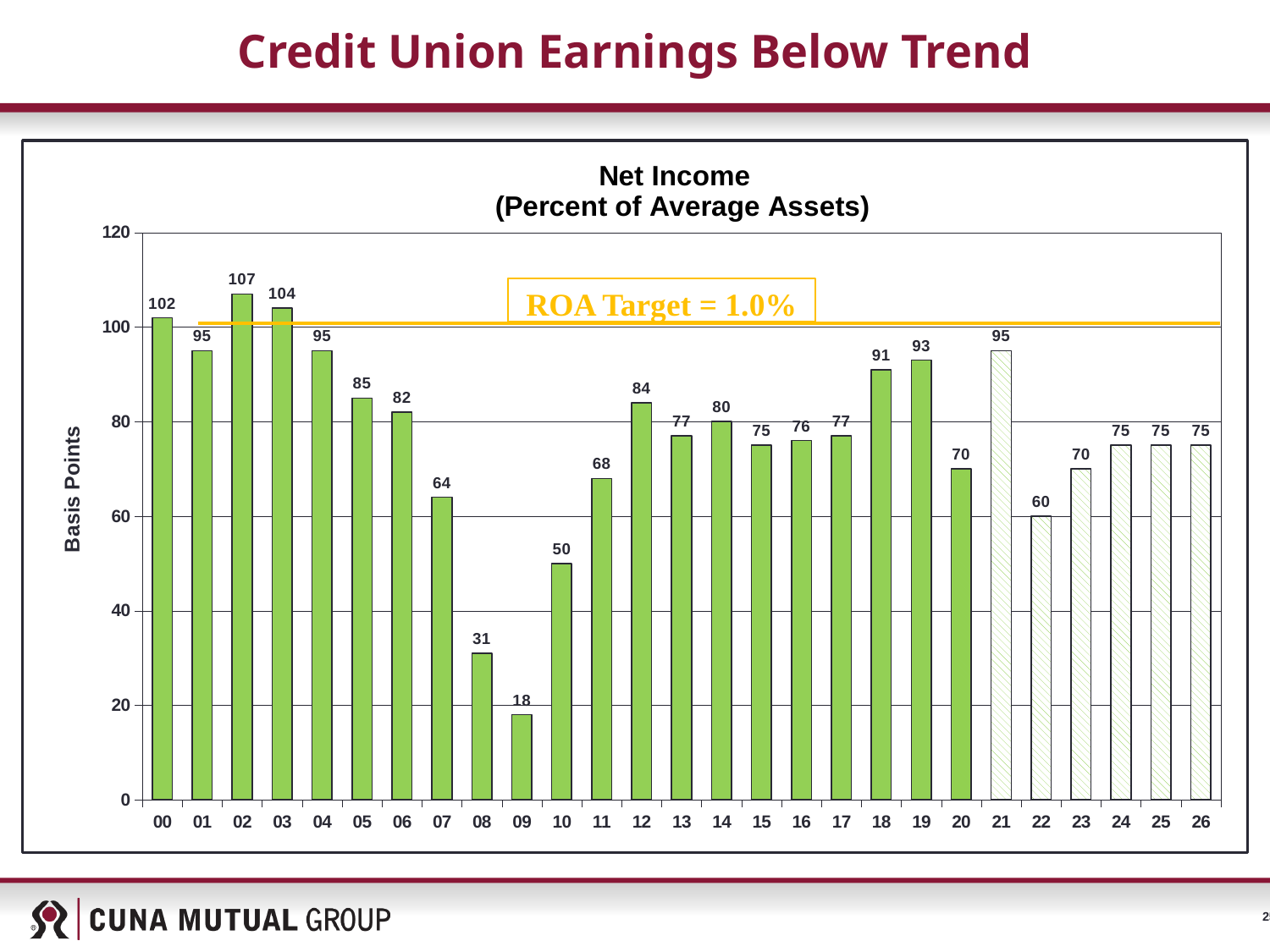
What is the difference between the values for 18 and 20? 21 Which is larger, the value for 12 or the value for 14? 12 What is the label on the y axis? Basis Points What kind of chart is shown? Bar chart Do the values rise or fall from 05 to 09? Fall Which year has the highest value? 02 What is the difference between the values for 02 and 09? 89 Which year has the lowest value? 09 What is the value for 19? 93 What is the value for 22? 60 What is the value for 09? 18 How many bars are plotted in the chart? 27